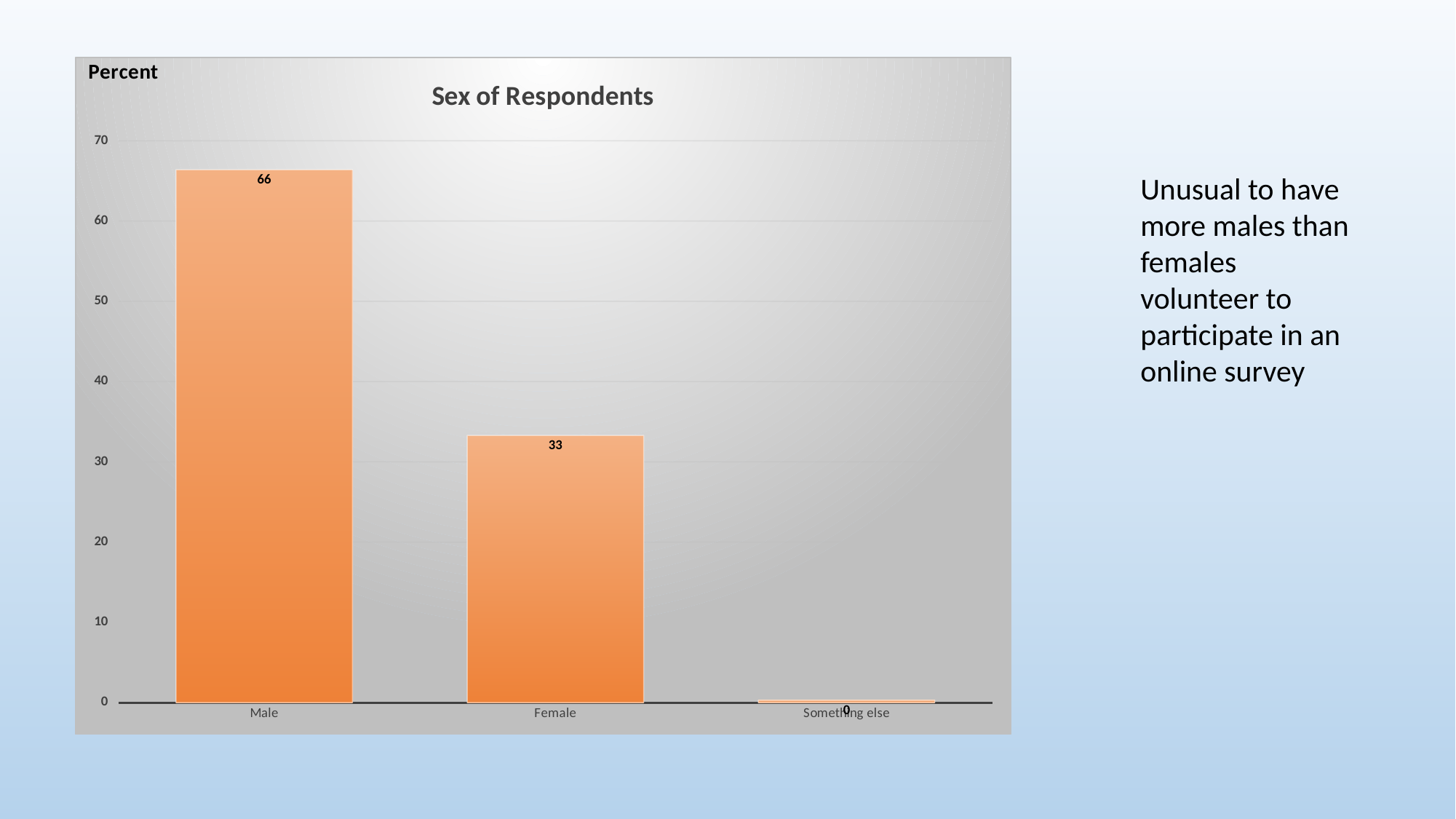
What is the value for Something else in the Sex of Respondents chart? 0 What is the title of the chart on the slide? Sex of Respondents What is the difference between the Male and Female values in the Sex of Respondents chart? 33 Is the value for Female in the Sex of Respondents chart greater or less than 40? less What is the value for Female in the Sex of Respondents chart? 33 What is the value for Male in the Sex of Respondents chart? 66 What label is shown on the vertical axis of the chart? Percent Which category has the lowest value in the Sex of Respondents chart? Something else What kind of chart is the Sex of Respondents chart? bar chart How many categories are shown in the Sex of Respondents chart? 3 Which is larger in the Sex of Respondents chart, the value for Male or the value for Female? Male Which category has the highest value in the Sex of Respondents chart? Male